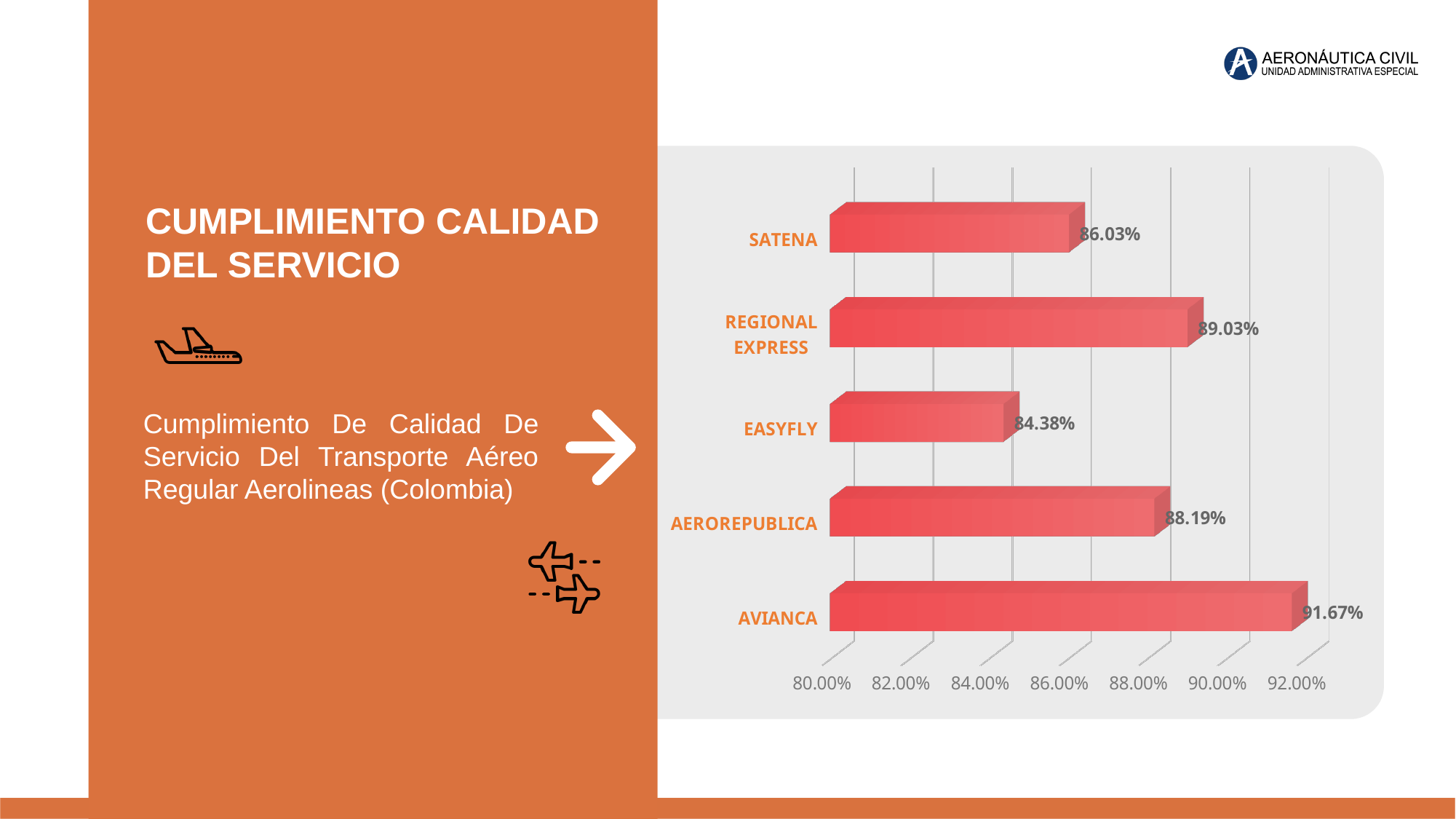
What is the value for REGIONAL EXPRESS? 89.03% What is the difference between the values for AVIANCA and EASYFLY? 7.29% What is the value for SATENA? 86.03% Which is larger, the value for SATENA or the value for AEROREPUBLICA? AEROREPUBLICA Which airline has the lowest value? EASYFLY How many airlines are shown in the chart? 5 Is the value for AEROREPUBLICA greater or less than 86.00%? greater What kind of chart is shown on the slide? bar chart What is the value for EASYFLY? 84.38% Which airline has the highest value? AVIANCA What is the difference between the values for REGIONAL EXPRESS and AEROREPUBLICA? 0.84% What is the value for AVIANCA? 91.67%